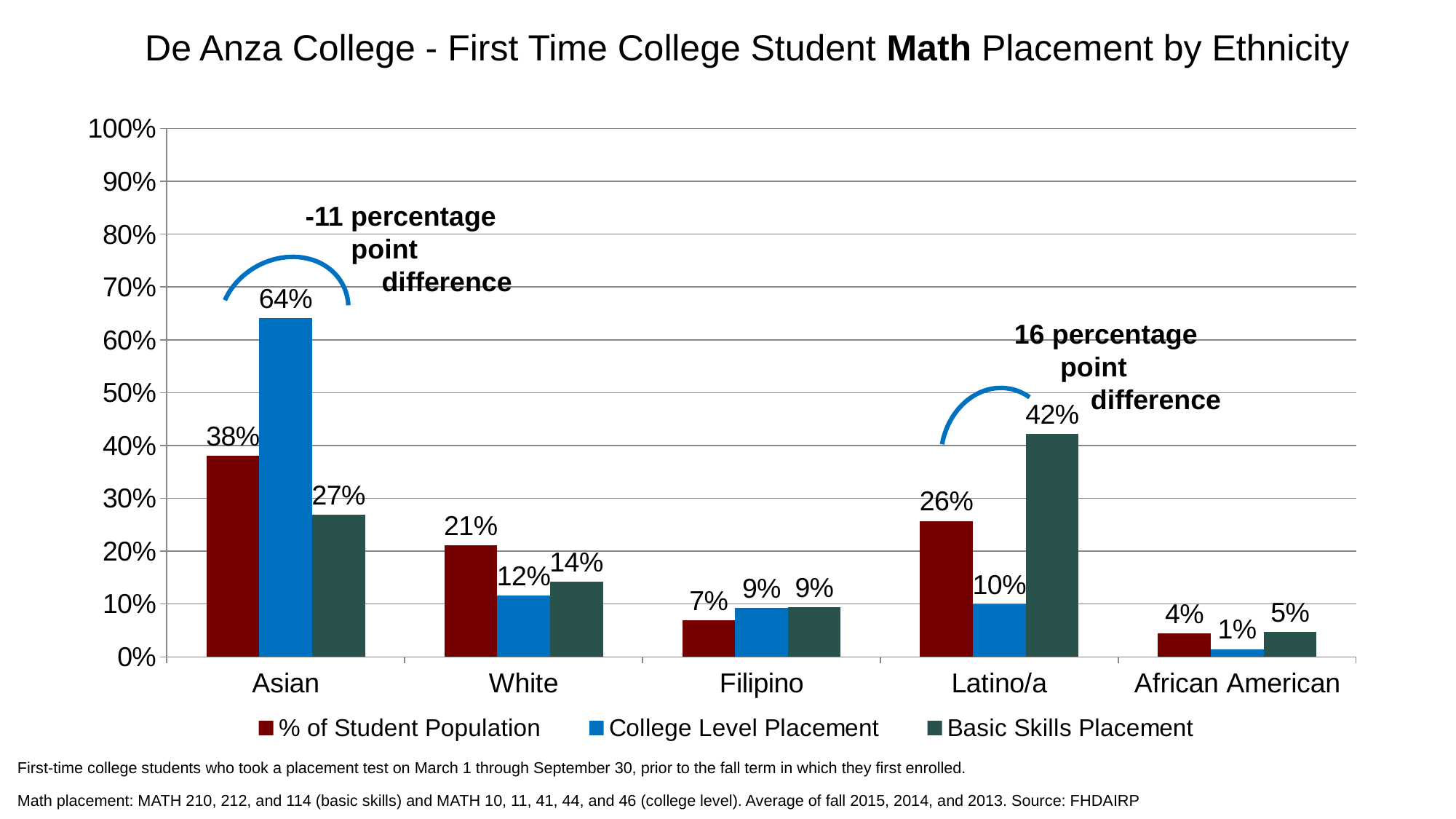
What kind of chart is shown on the slide? Bar chart How many series does the legend list? 3 What is the difference between the Basic Skills Placement and College Level Placement values for Latino/a students? 32% How many ethnicity categories are shown on the x axis? 5 What is the difference between the % of Student Population and College Level Placement values for African American students? 3% What is the title of the chart? De Anza College - First Time College Student Math Placement by Ethnicity Which ethnicity has the highest College Level Placement value? Asian Which ethnicity has the lowest % of Student Population value? African American What is the % of Student Population value for White students? 21% What is the College Level Placement value for Asian students? 64% What is the Basic Skills Placement value for Latino/a students? 42% Which is larger for White students: College Level Placement or Basic Skills Placement? Basic Skills Placement